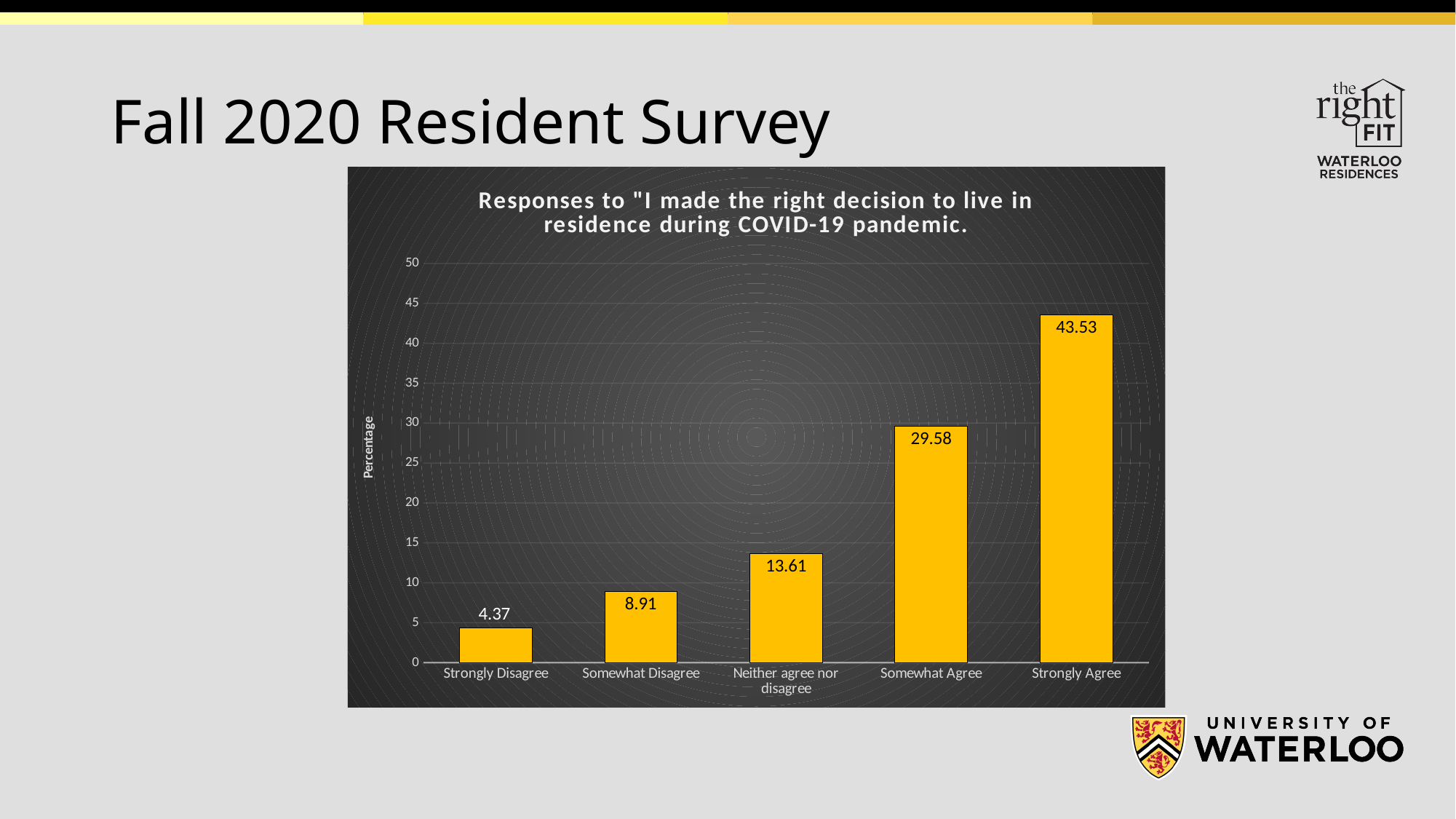
Do the values rise or fall moving from Strongly Disagree to Strongly Agree along the x axis? rise Which is larger, the value for Somewhat Disagree or the value for Neither agree nor disagree? Neither agree nor disagree What kind of chart is shown on the slide? bar chart What is the difference between the values for Strongly Agree and Somewhat Agree? 13.95 Which response category has the highest value? Strongly Agree What is the value for Somewhat Disagree? 8.91 What is the value for Strongly Agree? 43.53 What is the value for Neither agree nor disagree? 13.61 What is the label of the vertical axis? Percentage How many response categories are shown on the x axis? 5 Which response category has the lowest value? Strongly Disagree Is the value for Somewhat Agree greater or less than 25? greater